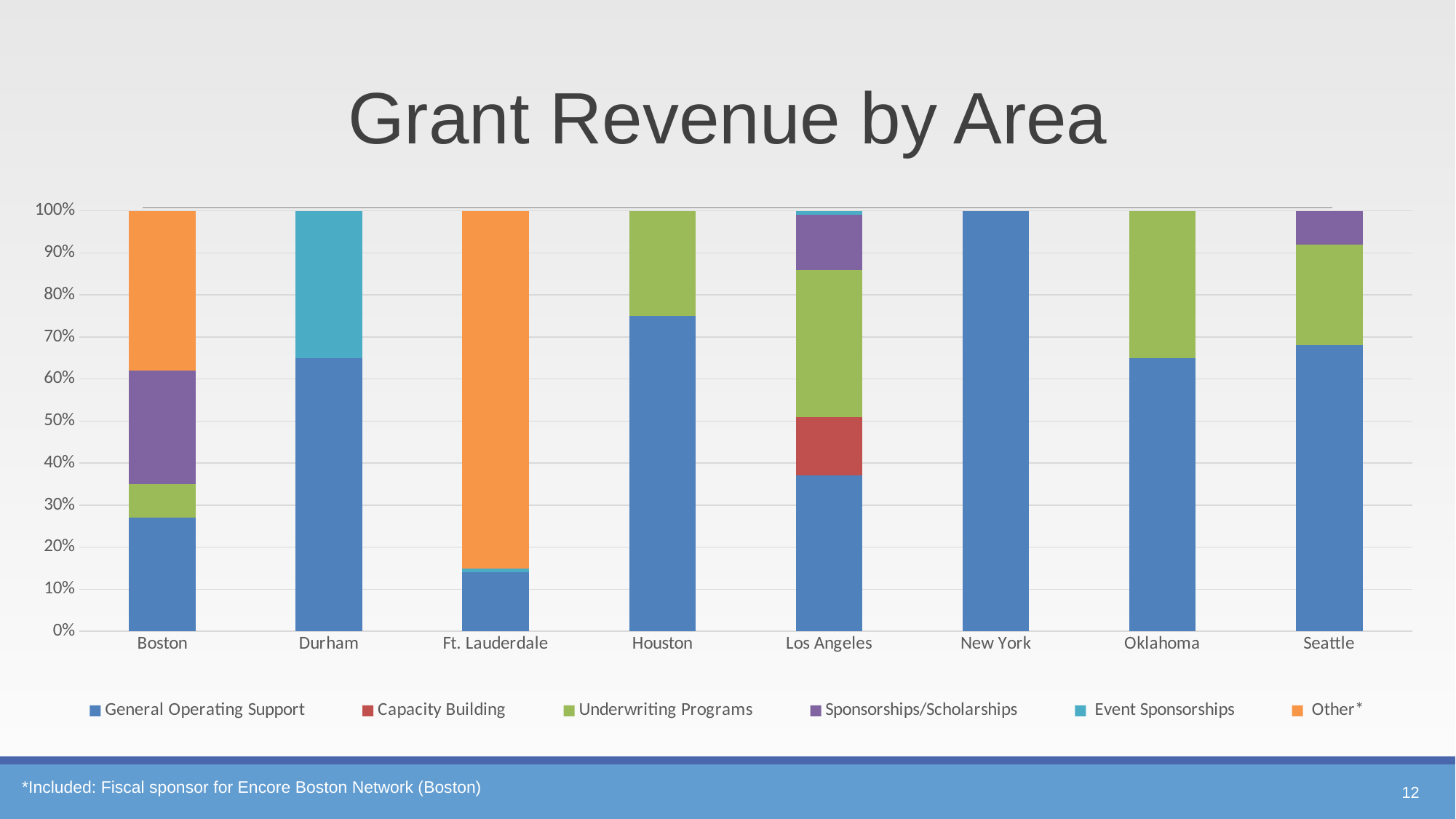
What kind of chart is shown on the slide? Stacked bar chart Is the General Operating Support share for Boston greater or less than 30%? less Which area has the lowest share of General Operating Support? Ft. Lauderdale Is the Other* share for Ft. Lauderdale greater or less than 80%? greater What is the title of the chart? Grant Revenue by Area Which is larger, the General Operating Support share for Boston or for Houston? Houston Which area is the only one with a Capacity Building segment? Los Angeles What is the General Operating Support share for New York? 100% Which area has the highest share of General Operating Support? New York How many series does the chart legend list? 6 Is the General Operating Support share for Houston greater or less than 70%? greater How many areas are shown along the x axis of the chart? 8